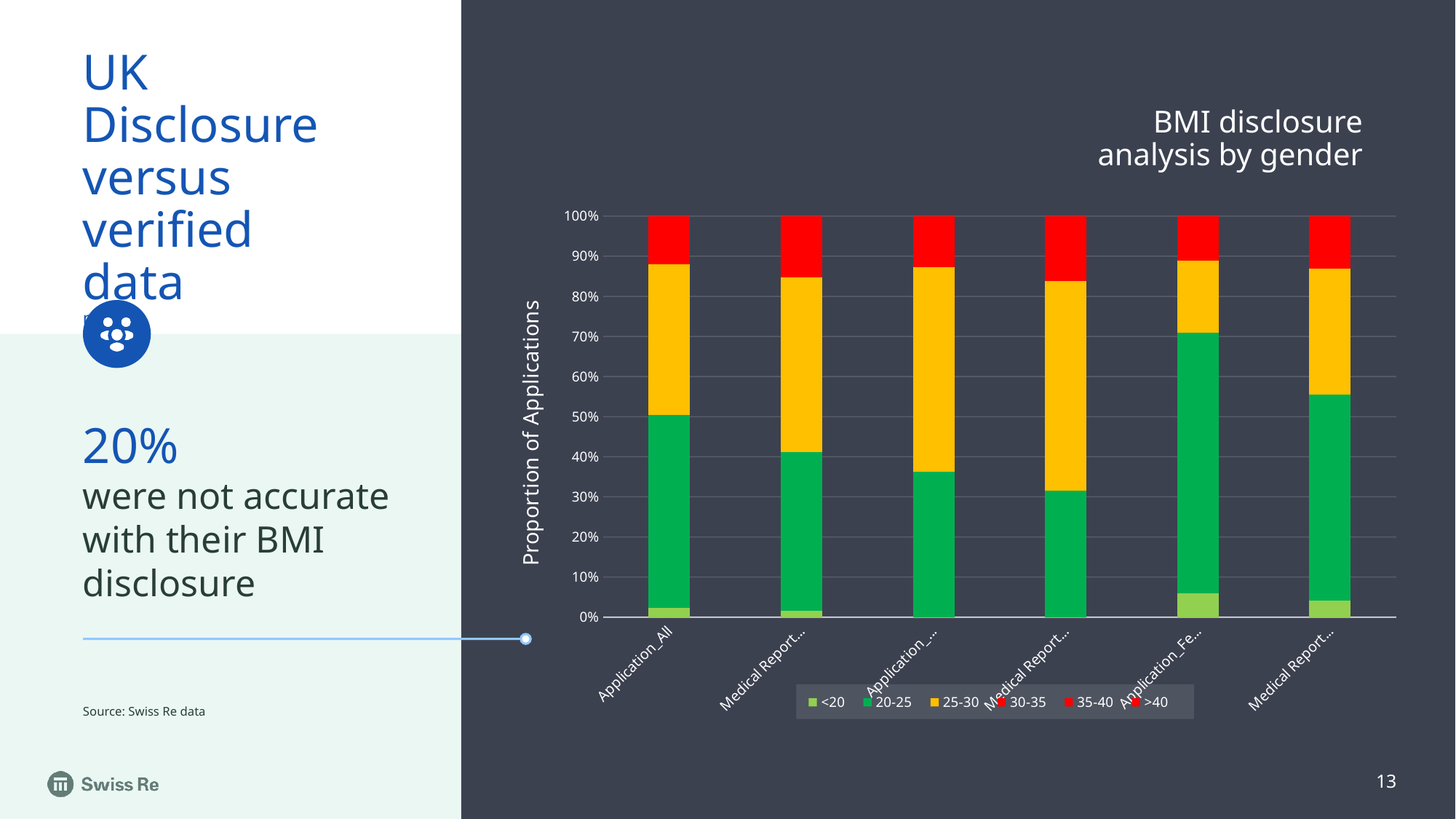
In the fourth bar from the left, is the top of the 20-25 segment greater or less than 40%? less What is the title of the chart? BMI disclosure analysis by gender What is the label on the vertical axis of the chart? Proportion of Applications Which bar has the largest 25-30 segment, the fourth bar from the left or the fifth bar from the left? The fourth bar from the left In the fifth bar from the left, is the top of the 20-25 segment greater or less than 60%? greater What type of chart is shown on the slide? Stacked bar chart How many stacked bars are plotted in the chart? 6 How many series does the chart legend list? 6 In the Application_All bar, is the top of the 20-25 segment greater or less than 40%? greater What is the total height of the Application_All bar? 100% Which bar has the largest 20-25 segment? The fifth bar from the left